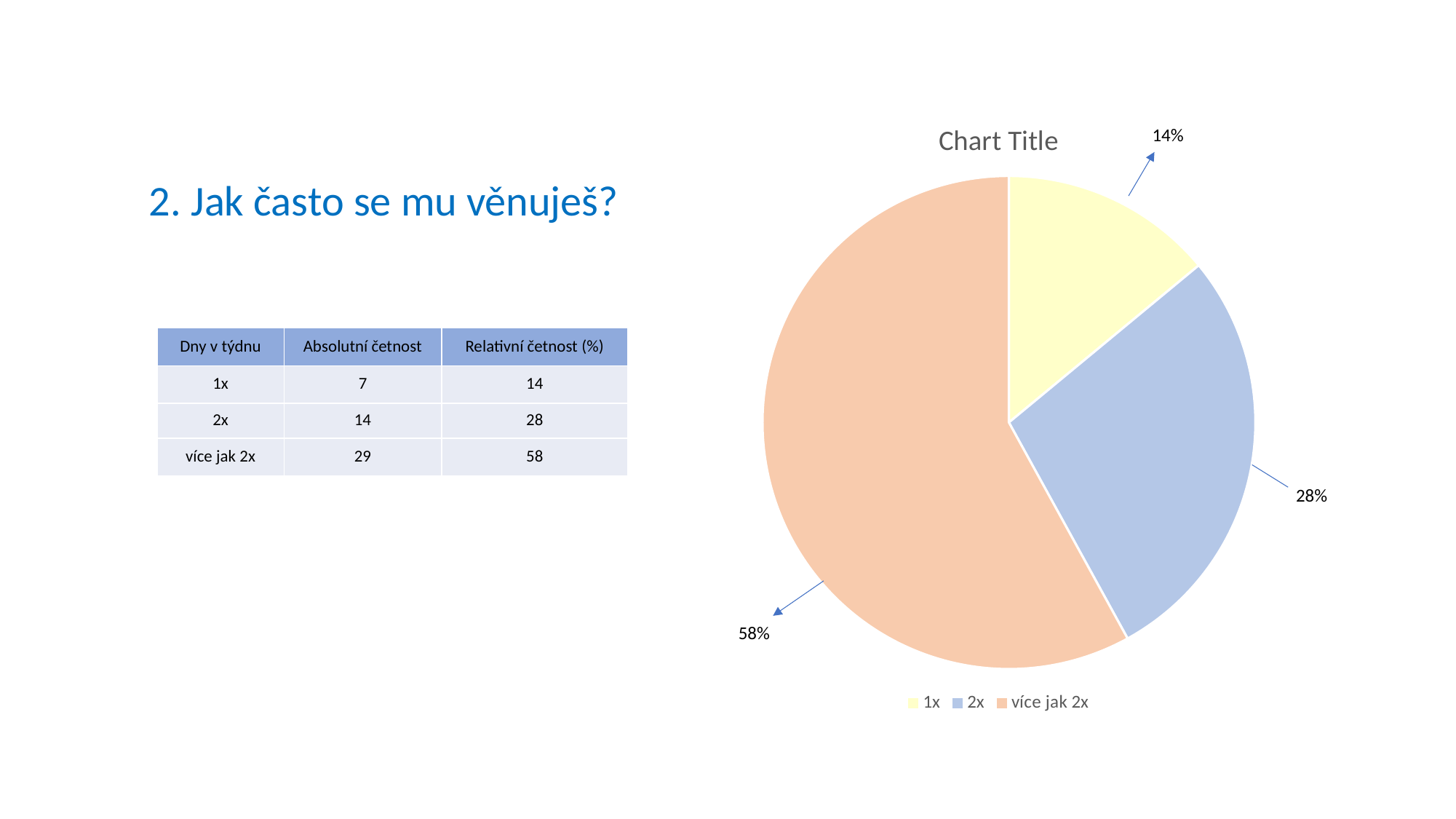
What kind of chart is shown on the slide? pie chart What is the difference in percentage points between the 'více jak 2x' slice and the '2x' slice? 30 What percentage is shown for the '2x' slice? 28% How many slices does the pie chart have? 3 Which slice is larger, '2x' or '1x'? 2x Which category has the smallest slice of the pie? 1x What percentage is shown for the '1x' slice? 14% Which category has the largest slice of the pie? více jak 2x What percentage is shown for the 'více jak 2x' slice? 58% How many entries does the chart legend list? 3 Which colour represents the 'více jak 2x' slice in the legend? orange What is the title of the chart? Chart Title